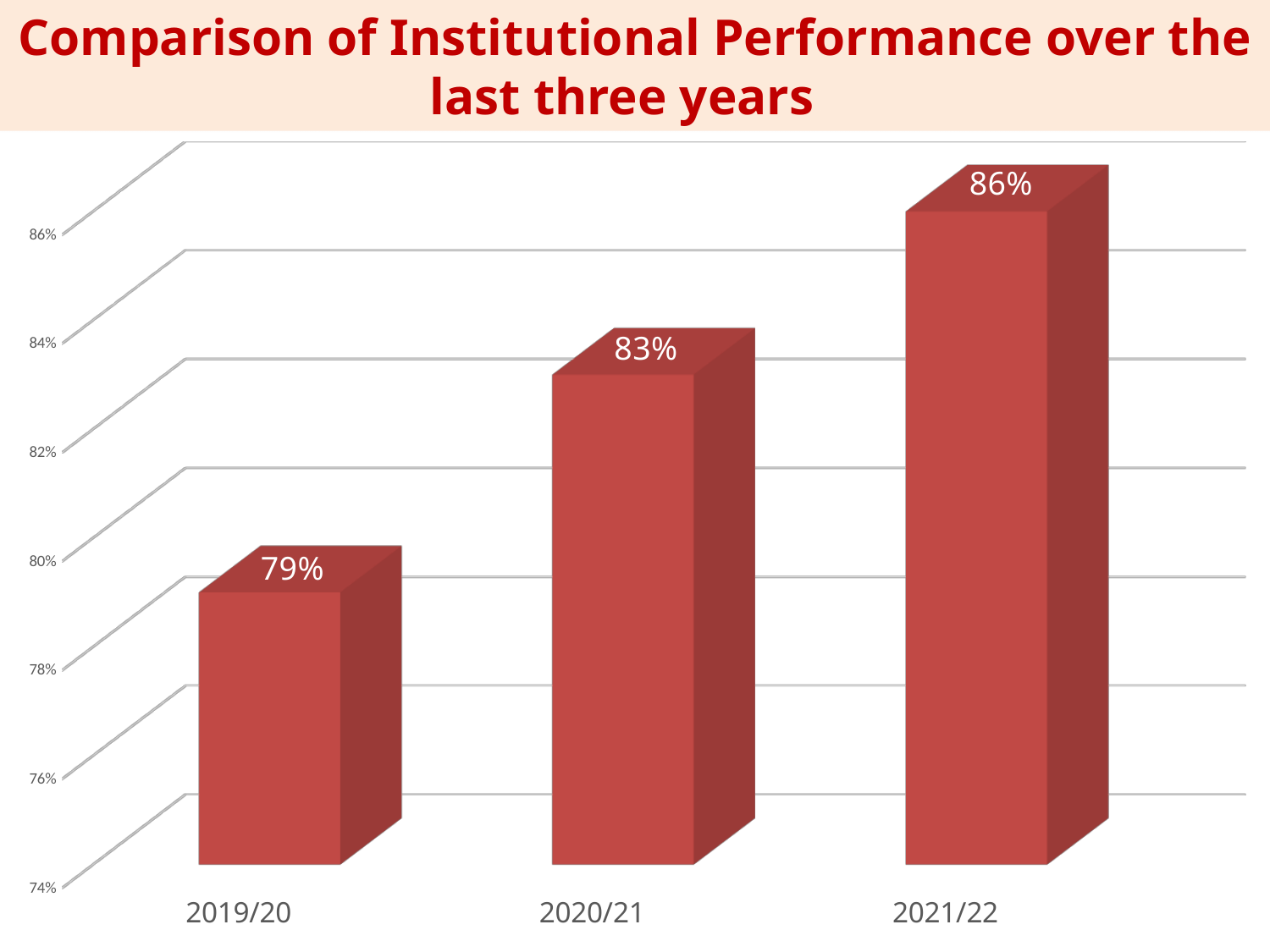
What is the value for 2019/20? 79% Which year has the lowest value? 2019/20 What is the value for 2020/21? 83% Is the value for 2020/21 greater or less than 80%? greater What kind of chart is shown on the slide? bar chart Which year has the highest value? 2021/22 Which is larger, the value for 2020/21 or the value for 2021/22? 2021/22 How many years are shown on the chart? 3 What is the value for 2021/22? 86% What is the difference between the values for 2021/22 and 2019/20? 7% What is the difference between the values for 2020/21 and 2019/20? 4% Do the values rise or fall from 2019/20 to 2021/22? rise